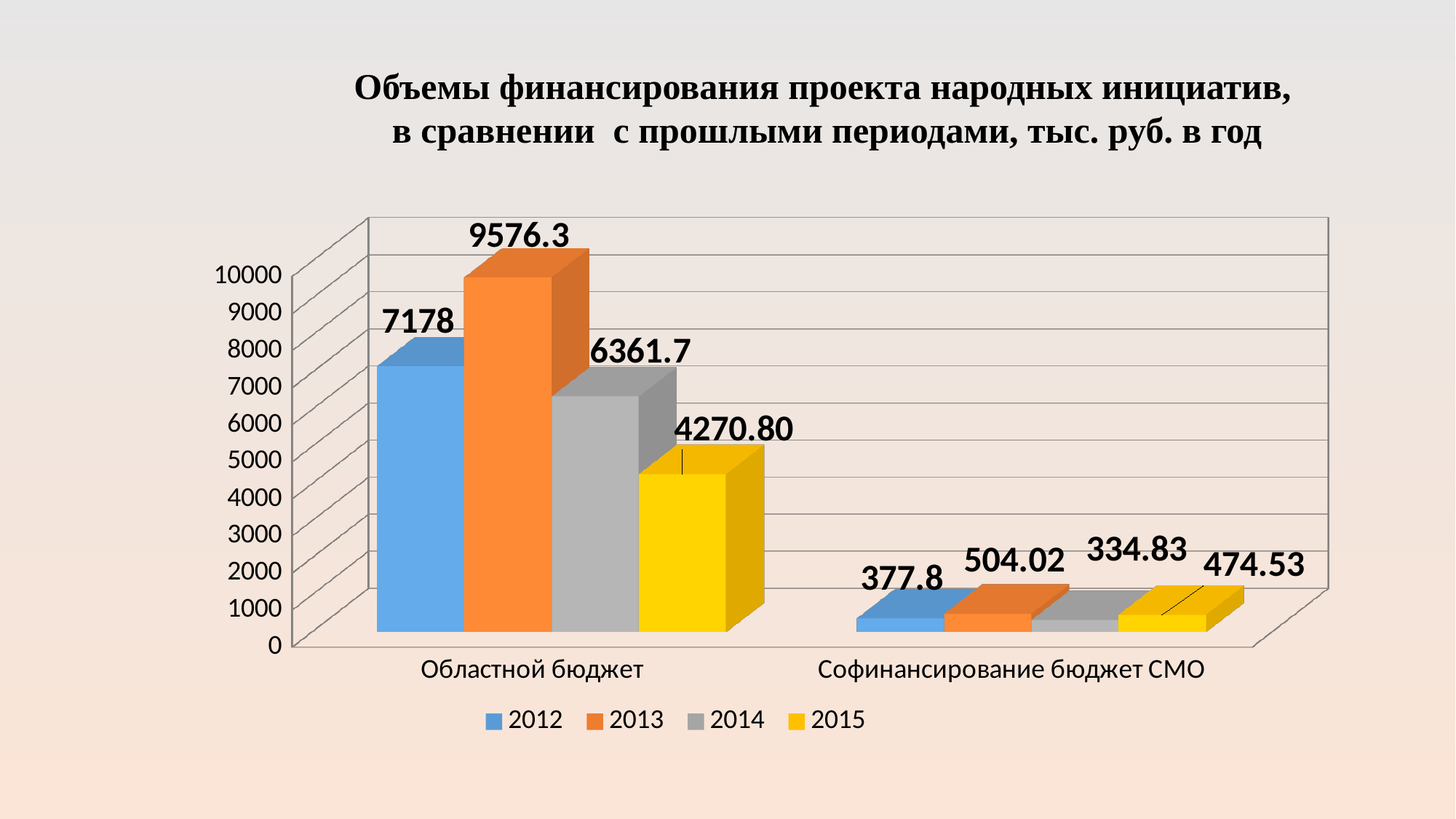
What is the difference between the 2013 and 2014 values in the Софинансирование бюджет СМО category? 169.19 What is the value for 2014 in the Софинансирование бюджет СМО category? 334.83 What is the value for 2013 in the Областной бюджет category? 9576.3 What is the value for 2012 in the Софинансирование бюджет СМО category? 377.8 What is the value for 2015 in the Областной бюджет category? 4270.80 What kind of chart is shown on the slide? Bar chart How many categories are shown on the x axis? 2 What is the difference between the 2013 and 2012 values in the Областной бюджет category? 2398.3 Which year has the lowest value in the Софинансирование бюджет СМО category? 2014 How many series does the legend list? 4 Which is larger in the Софинансирование бюджет СМО category: the 2015 value or the 2012 value? 2015 Which year has the highest value in the Областной бюджет category? 2013